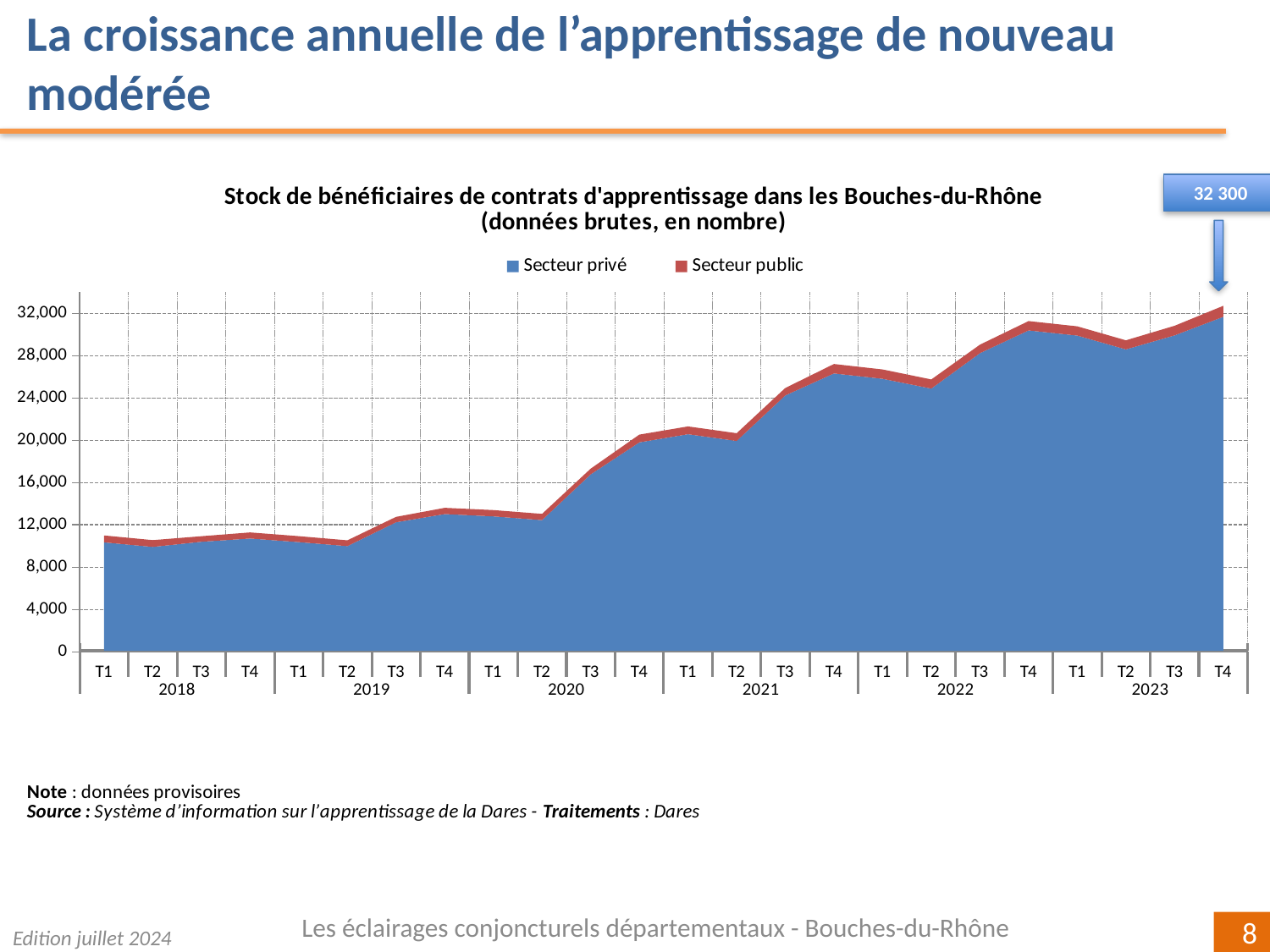
Which series accounts for the larger share of the stock, Secteur privé or Secteur public? Secteur privé In which quarter is the total stock of apprenticeship beneficiaries highest? T4 2023 Overall, do the values rise or fall from 2018 to 2023? Rise What are the two series named in the legend? Secteur privé and Secteur public What kind of chart is shown on the slide? Stacked area chart Is the total value for T2 2020 greater or less than 16,000? less How many quarterly data points are plotted along the x axis? 24 What total value is annotated for T4 2023? 32 300 How many series does the legend list? 2 Is the total value for T3 2021 greater or less than 24,000? greater Which is larger, the total for T4 2019 or the total for T4 2020? T4 2020 Is the total value for T1 2018 greater or less than 12,000? less